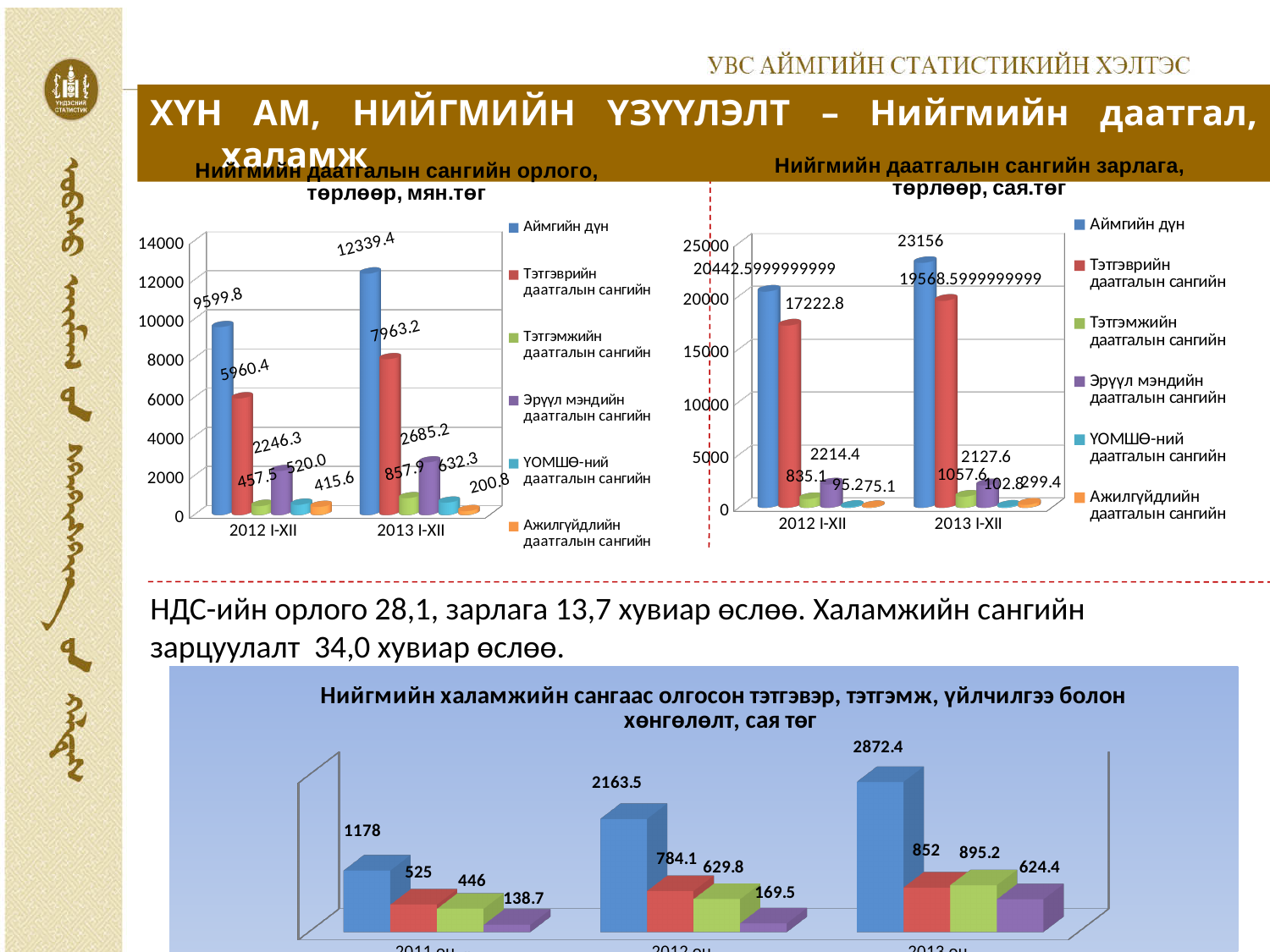
In the chart 'Нийгмийн даатгалын сангийн орлого, төрлөөр, мян.төг', which series has the lowest value for 2013 I-XII? Ажилгүйдлийн даатгалын сангийн In the chart 'Нийгмийн даатгалын сангийн орлого, төрлөөр, мян.төг', what is the difference between Аймгийн дүн in 2013 I-XII and 2012 I-XII? 2739.6 In the chart 'Нийгмийн даатгалын сангийн зарлага, төрлөөр, сая.төг', what kind of chart is shown? bar chart In the chart 'Нийгмийн даатгалын сангийн орлого, төрлөөр, мян.төг', what is the value of Аймгийн дүн for 2013 I-XII? 12339.4 In the bottom chart 'Нийгмийн халамжийн сангаас олгосон тэтгэвэр, тэтгэмж, үйлчилгээ болон хөнгөлөлт, сая төг', what is the value of the tallest (blue) bar for 2013 он? 2872.4 In the bottom chart 'Нийгмийн халамжийн сангаас олгосон тэтгэвэр, тэтгэмж, үйлчилгээ болон хөнгөлөлт, сая төг', does the value of the blue bar rise or fall from 2011 он to 2013 он? rise In the chart 'Нийгмийн даатгалын сангийн зарлага, төрлөөр, сая.төг', what is the value of Аймгийн дүн for 2013 I-XII? 23156 In the chart 'Нийгмийн даатгалын сангийн зарлага, төрлөөр, сая.төг', is the value of Эрүүл мэндийн даатгалын сангийн for 2012 I-XII greater or less than 2013 I-XII? greater In the bottom chart 'Нийгмийн халамжийн сангаас олгосон тэтгэвэр, тэтгэмж, үйлчилгээ болон хөнгөлөлт, сая төг', how many year categories are shown on the x axis? 3 In the chart 'Нийгмийн даатгалын сангийн зарлага, төрлөөр, сая.төг', what is the value of Тэтгэврийн даатгалын сангийн for 2012 I-XII? 17222.8 In the chart 'Нийгмийн даатгалын сангийн орлого, төрлөөр, мян.төг', how many series does the legend list? 6 In the chart 'Нийгмийн даатгалын сангийн орлого, төрлөөр, мян.төг', what is the value of Тэтгэврийн даатгалын сангийн for 2012 I-XII? 5960.4